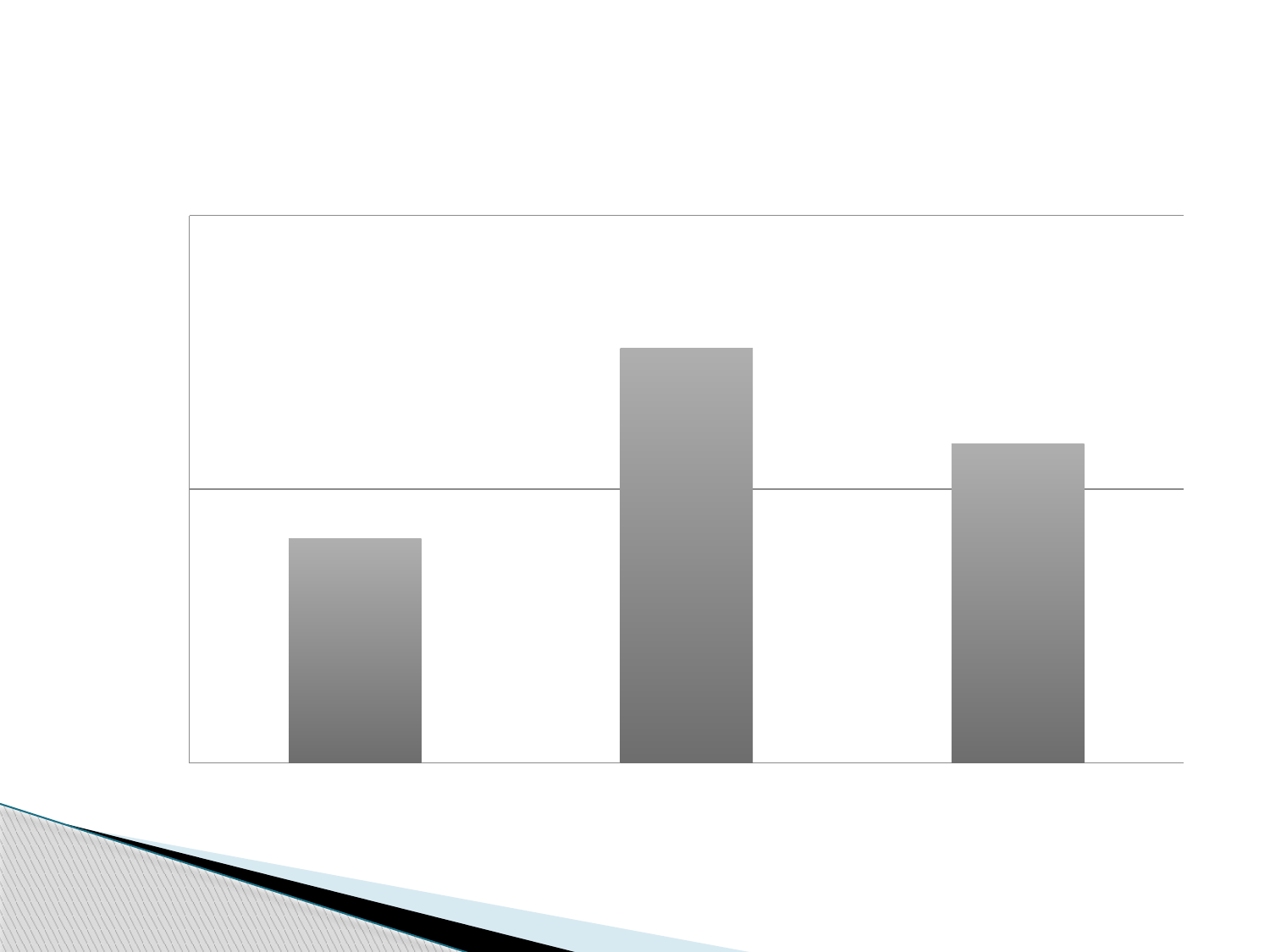
Do the bar heights rise or fall from the middle bar to the right bar? fall Does the chart display a legend? No Which is taller, the left bar or the right bar? right bar What kind of chart is shown on the slide? bar chart Which bar is the shortest: the left, middle, or right bar? left Are the bars in the chart vertical or horizontal? vertical How many bars are plotted in the chart? 3 Do the bar heights rise or fall from the left bar to the middle bar? rise Which bar is the tallest: the left, middle, or right bar? middle Which is taller, the middle bar or the right bar? middle bar